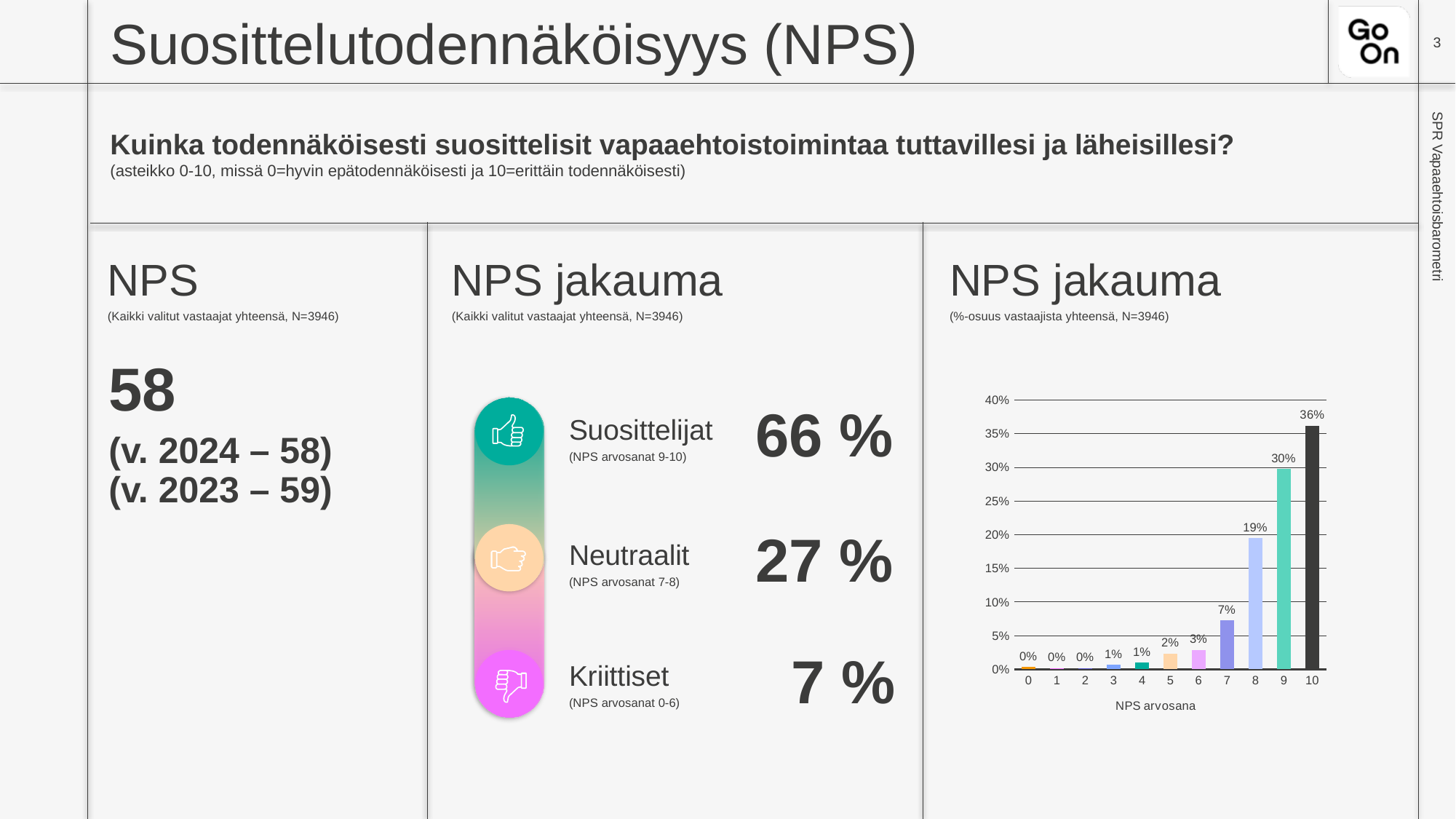
In the NPS jakauma bar chart, what percentage of respondents gave an NPS score of 10? 36% What type of chart is the NPS jakauma chart on the right of the slide? bar chart In the NPS jakauma bar chart, do the values generally rise or fall as the NPS score increases from 0 to 10? rise In the NPS jakauma bar chart, which has a larger share of respondents, NPS score 8 or NPS score 7? 8 How many NPS score categories are shown on the x axis of the NPS jakauma bar chart? 11 In the NPS jakauma bar chart, what percentage of respondents gave an NPS score of 9? 30% What is the x-axis title of the NPS jakauma bar chart? NPS arvosana In the NPS jakauma bar chart, what is the difference between the shares for NPS scores 10 and 9? 6% In the NPS jakauma bar chart, what percentage of respondents gave an NPS score of 5? 2% In the NPS jakauma bar chart, which NPS score has the highest share of respondents? 10 In the NPS jakauma bar chart, what percentage of respondents gave an NPS score of 8? 19% In the NPS jakauma bar chart, what percentage of respondents gave an NPS score of 7? 7%